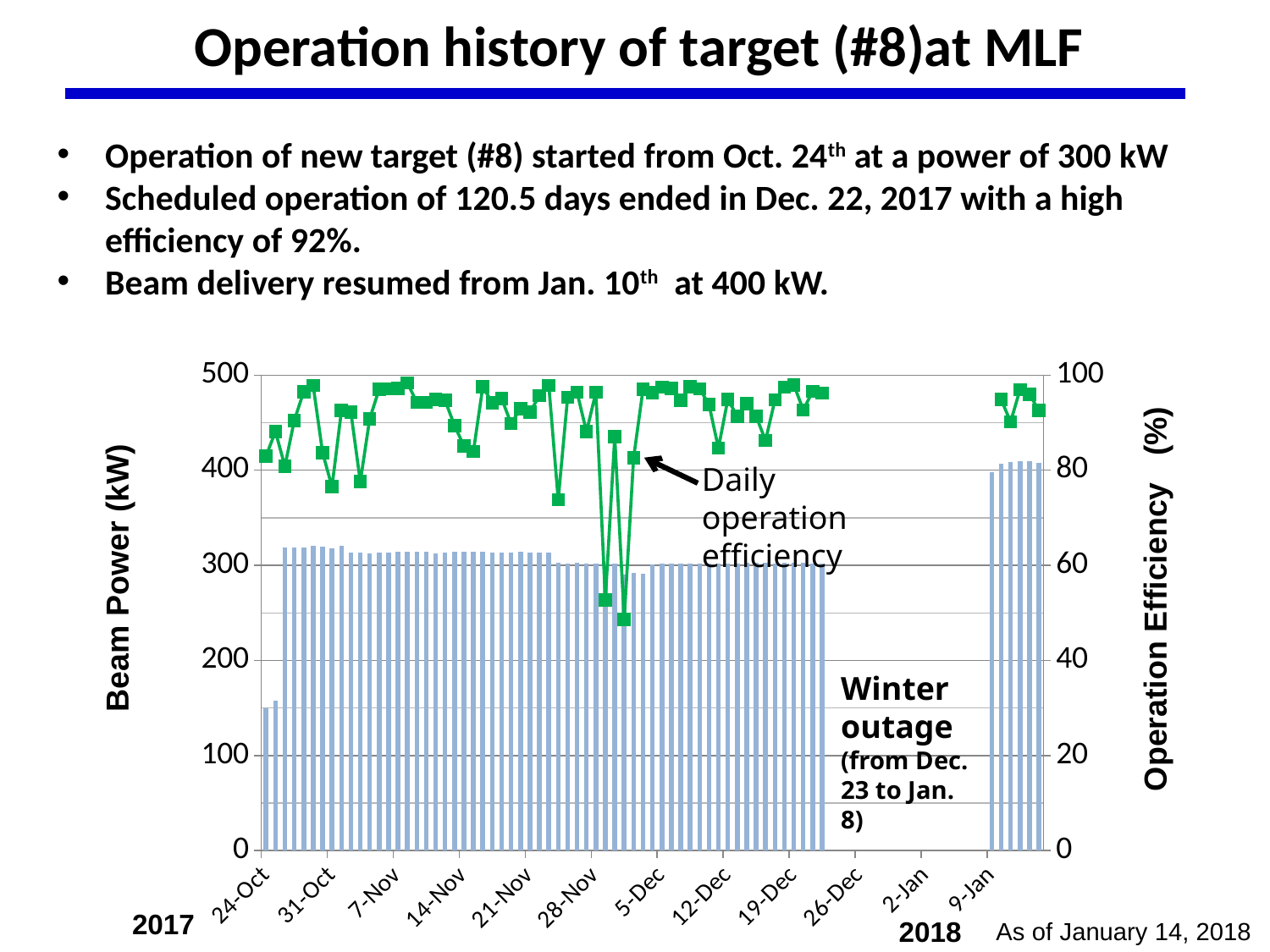
How many data series are plotted on the chart? 2 On which date is the beam power bar the lowest? 24-Oct Are the daily operation efficiency values in January greater or less than 80%? greater Which is higher, the beam power in January 2018 or the beam power in November 2017? January 2018 Is the beam power on 7-Nov greater or less than 400 kW? less Is the beam power on 9-Jan greater or less than 300 kW? greater What kind of chart is shown on the slide? bar and line chart Does the beam power rise or fall between 24-Oct and 31-Oct? rises What period is labelled as the winter outage on the chart? from Dec. 23 to Jan. 8 What does the green line on the chart represent? Daily operation efficiency